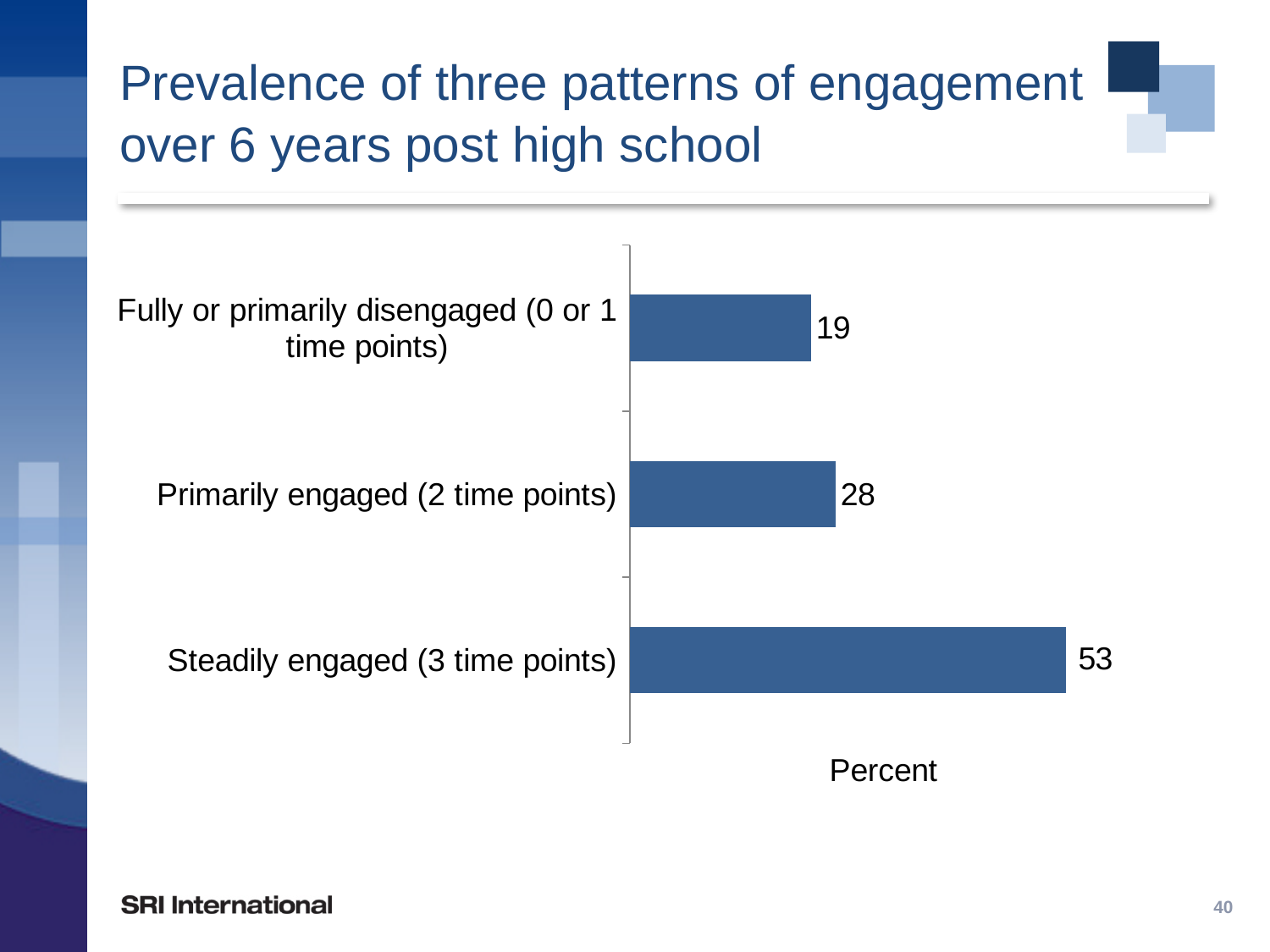
Which category has the lowest value? Fully or primarily disengaged (0 or 1 time points) What is the title of the slide? Prevalence of three patterns of engagement over 6 years post high school What is the label on the horizontal axis of the chart? Percent What kind of chart is shown on the slide? Bar chart What is the value for Steadily engaged (3 time points)? 53 How many categories are shown in the chart? 3 Which is larger, the value for Primarily engaged (2 time points) or the value for Fully or primarily disengaged (0 or 1 time points)? Primarily engaged (2 time points) What is the difference between the values for Steadily engaged (3 time points) and Primarily engaged (2 time points)? 25 Which category has the highest value? Steadily engaged (3 time points) What is the difference between the values for Primarily engaged (2 time points) and Fully or primarily disengaged (0 or 1 time points)? 9 What is the value for Fully or primarily disengaged (0 or 1 time points)? 19 What is the value for Primarily engaged (2 time points)? 28